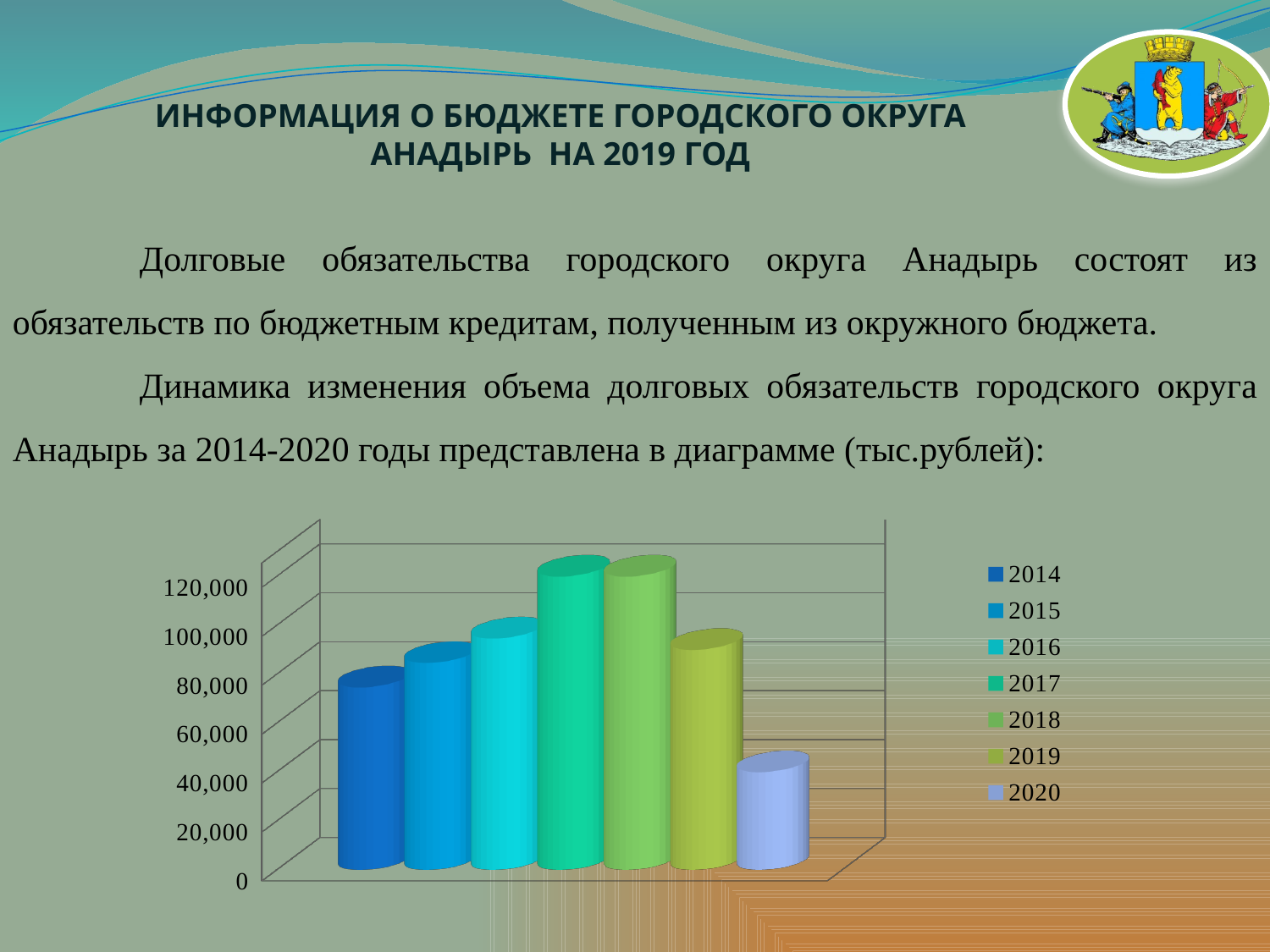
Which is larger, the value for 2017 or the value for 2020? 2017 Which year has the lowest value in the chart? 2020 How many bars (years) are plotted in the chart? 7 What kind of chart is shown on the slide? Bar chart Is the value for 2020 greater or less than 60,000? less Do the values rise or fall from 2014 to 2017? rise Do the values rise or fall from 2018 to 2020? fall How many entries does the chart legend list? 7 Is the value for 2014 greater or less than 100,000? less Which is larger, the value for 2014 or the value for 2016? 2016 Is the value for 2017 greater or less than 100,000? greater